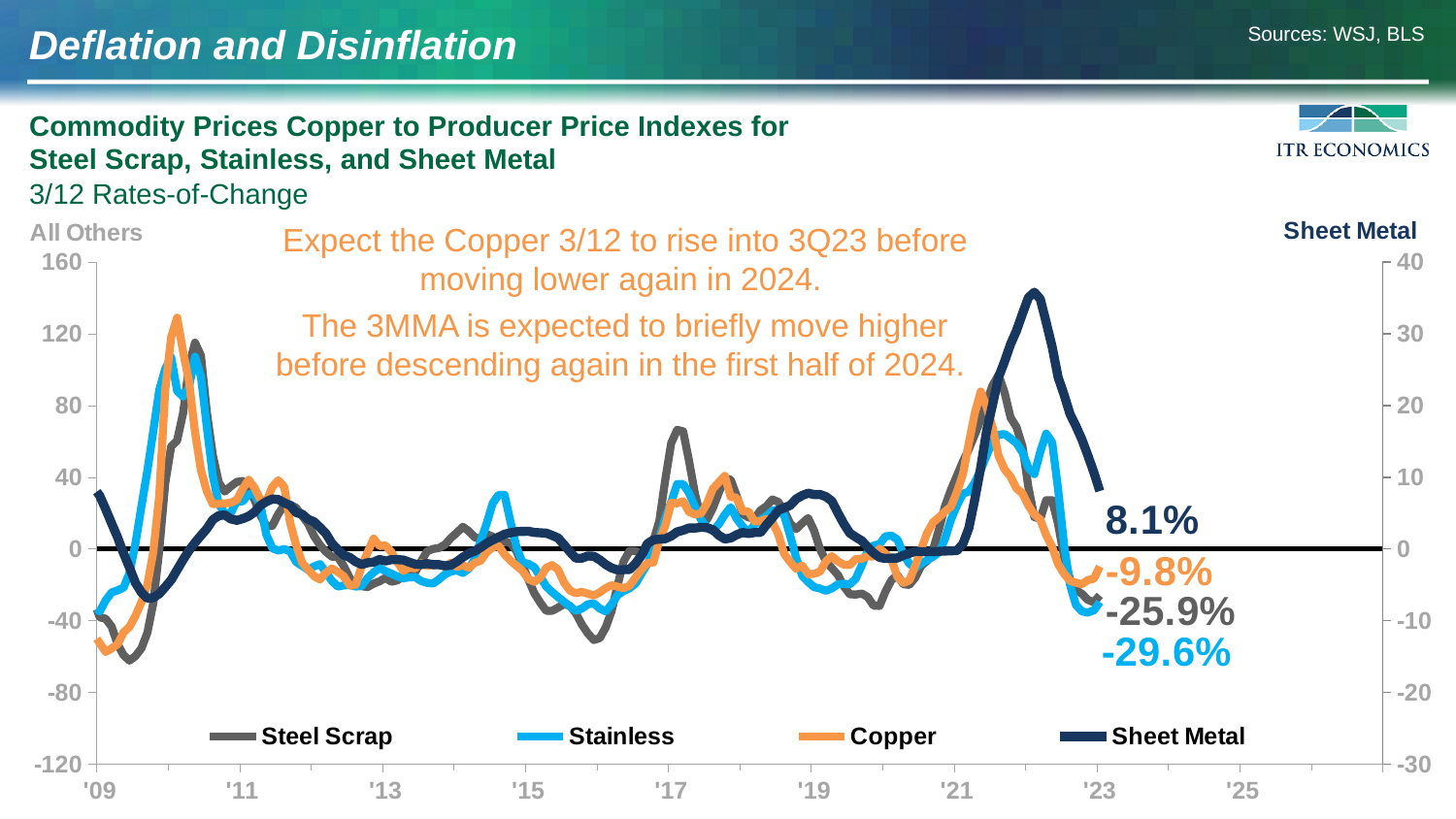
What is the latest labeled value for Steel Scrap? -25.9% Which is larger, the latest labeled value for Copper or for Steel Scrap? Copper What kind of chart is shown on the slide? Line chart What is the latest labeled value for Copper? -9.8% How many series does the legend list? 4 Which series has the lowest latest labeled value? Stainless Which series has the highest latest labeled value? Sheet Metal What is the difference between the latest labeled values for Copper and Stainless? 19.8 percentage points Is the peak of the Sheet Metal line around 2022 greater or less than 30 on the right-hand axis? greater What is the latest labeled value for Sheet Metal? 8.1% Which series is plotted against the right-hand axis? Sheet Metal What is the latest labeled value for Stainless? -29.6%